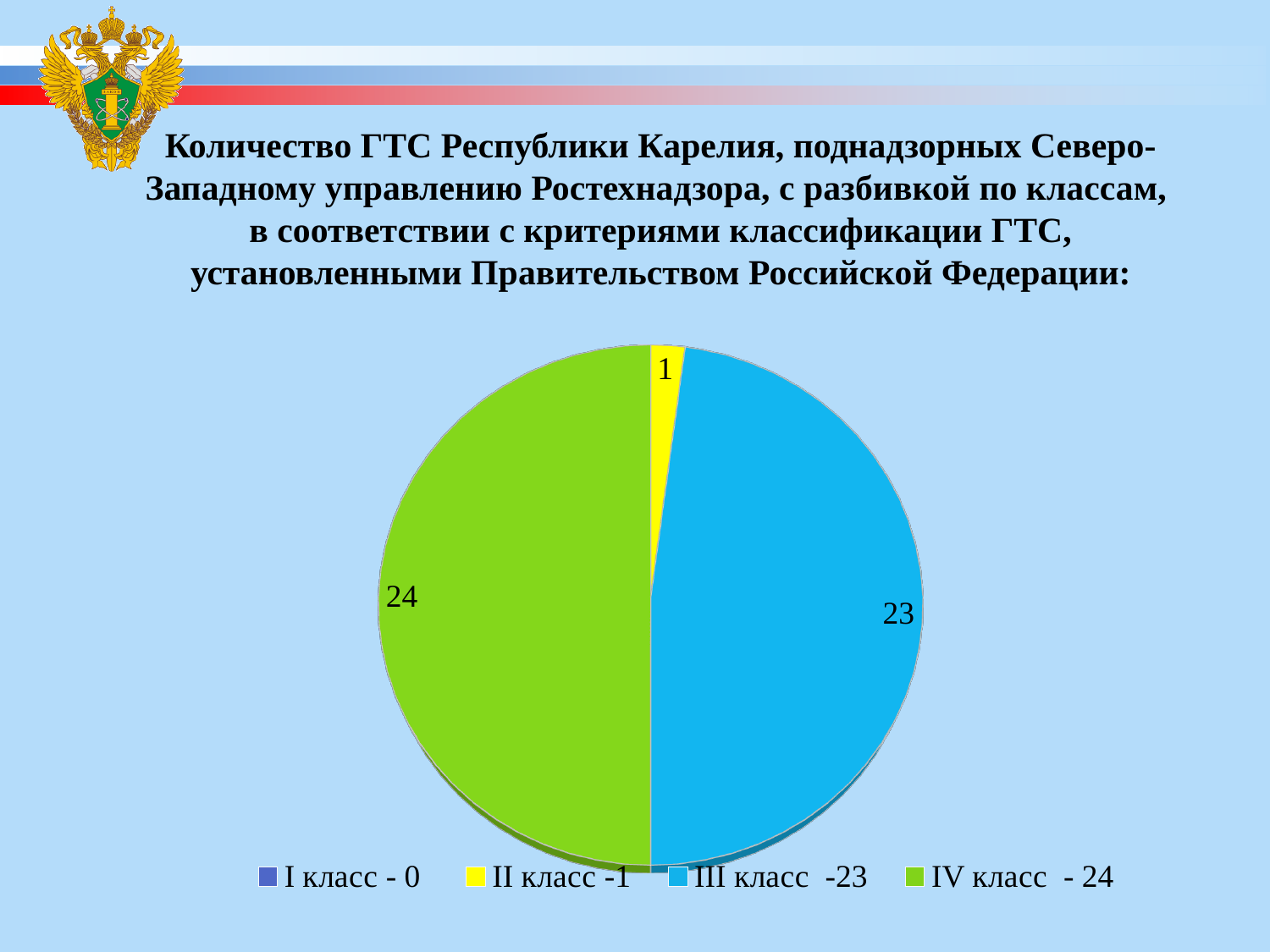
Which class with a visible slice has the smallest value? II класс What is the value for IV класс? 24 Which class has the largest slice of the pie? IV класс What share of the pie does IV класс represent? 50% What is the value for I класс according to the legend? 0 What is the total of all the values shown in the legend? 48 What is the value for II класс? 1 What kind of chart is shown on the slide? pie chart What is the value for III класс? 23 Which is larger, the value for III класс or the value for II класс? III класс What is the difference between the values for IV класс and III класс? 1 How many entries does the legend list? 4